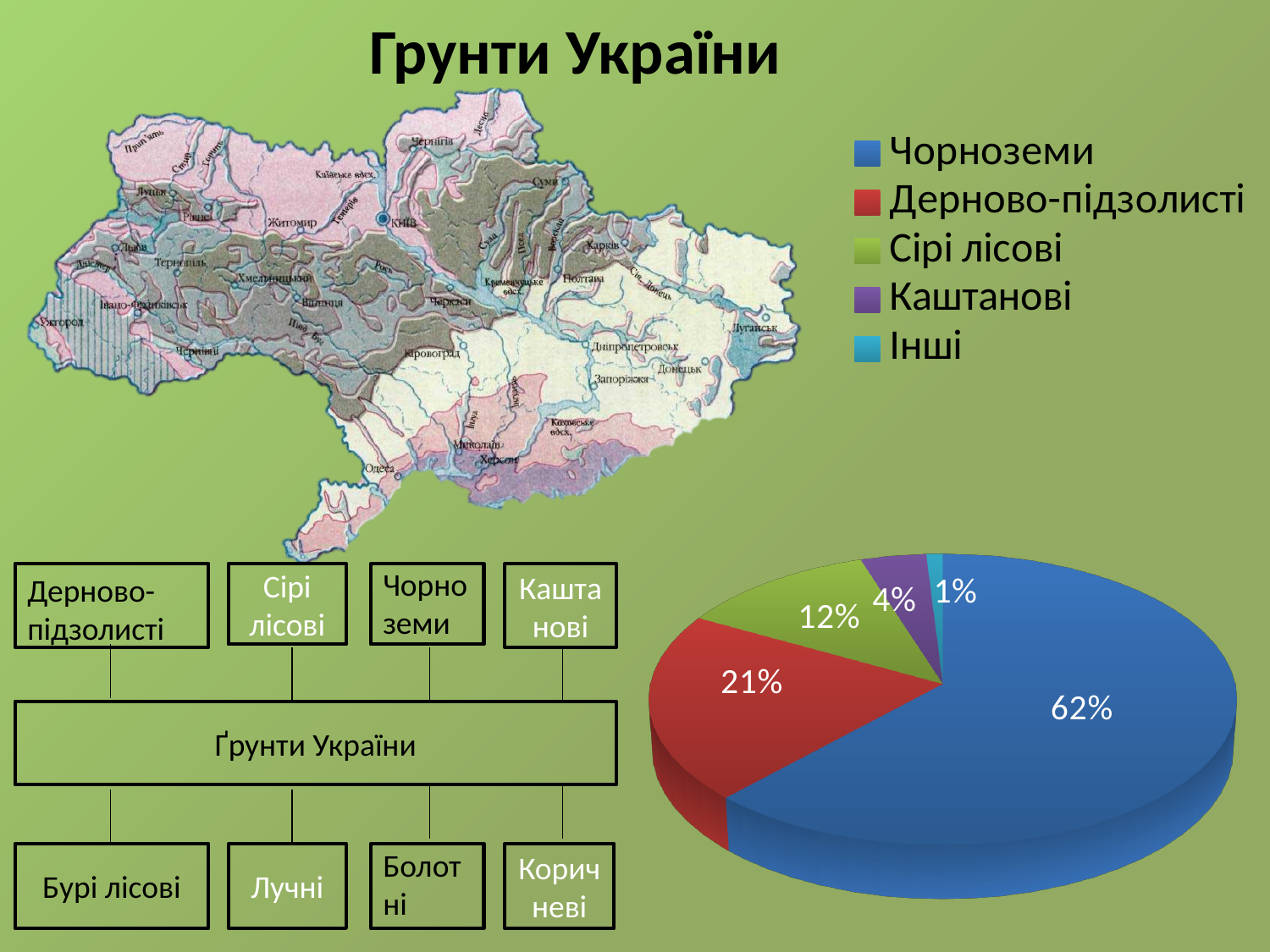
What colour is the Чорноземи slice in the pie chart? blue What share of the pie chart does Чорноземи have? 62% What share of the pie chart does Сірі лісові have? 12% What kind of chart is shown on the slide? pie chart What share of the pie chart does Каштанові have? 4% How many categories does the pie chart legend list? 5 Which is larger in the pie chart, Сірі лісові or Каштанові? Сірі лісові Which category has the smallest slice of the pie chart? Інші What is the difference in percentage points between Чорноземи and Дерново-підзолисті? 41 What share of the pie chart does Дерново-підзолисті have? 21% Which category has the largest slice of the pie chart? Чорноземи What share of the pie chart does Інші have? 1%